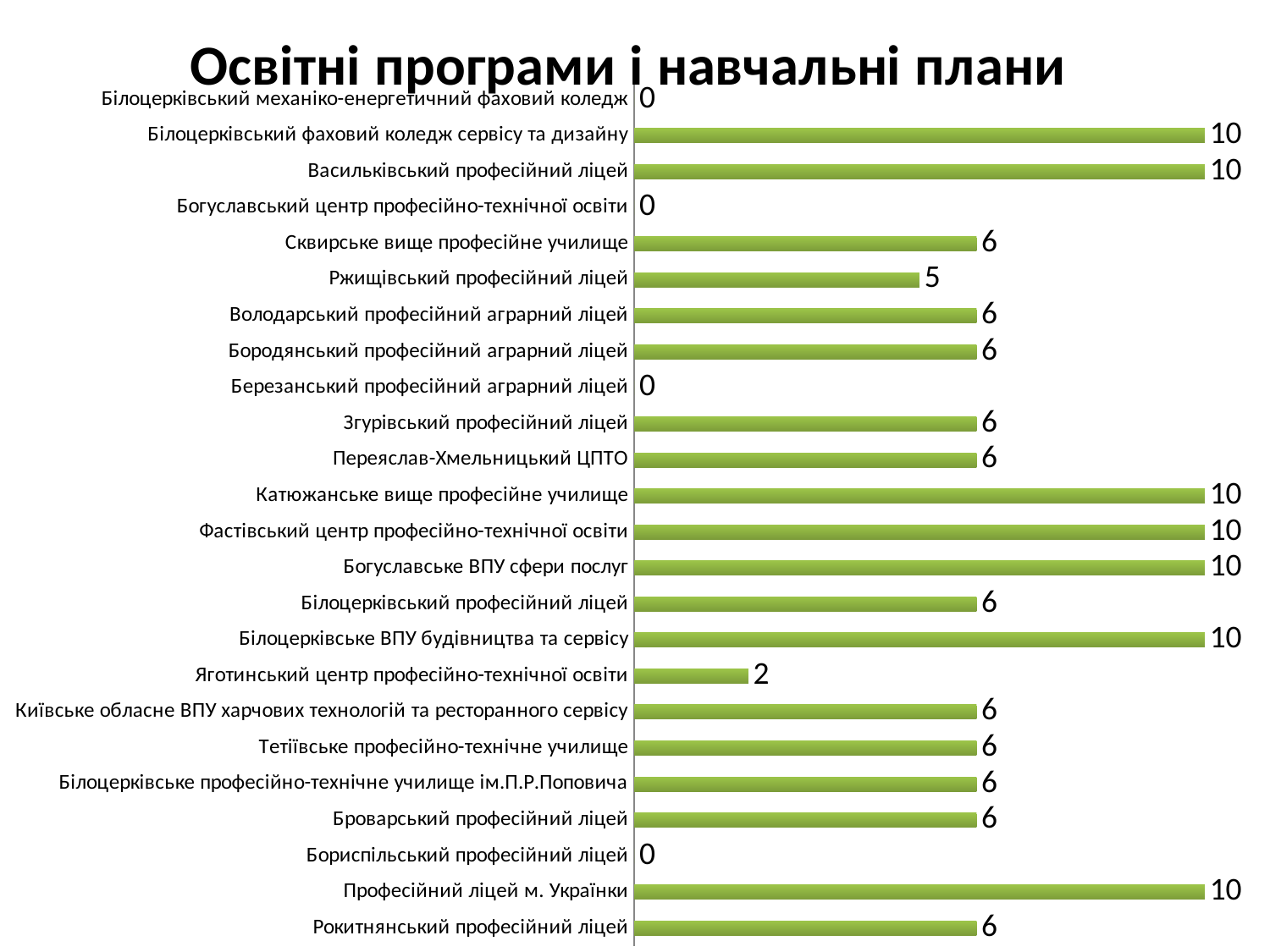
Which has a larger value, Ржищівський професійний ліцей or Броварський професійний ліцей? Броварський професійний ліцей What is the value for Катюжанське вище професійне училище? 10 How many categories are shown in the chart? 24 What is the difference between the values for Сквирське вище професійне училище and Яготинський центр професійно-технічної освіти? 4 What is the value for Яготинський центр професійно-технічної освіти? 2 What type of chart is shown on the slide? Bar chart Which has a larger value, Богуславське ВПУ сфери послуг or Білоцерківський професійний ліцей? Богуславське ВПУ сфери послуг What is the value for Рокитнянський професійний ліцей? 6 What is the value for Ржищівський професійний ліцей? 5 What is the difference between the values for Васильківський професійний ліцей and Ржищівський професійний ліцей? 5 What is the value for Бориспільський професійний ліцей? 0 How many categories have a value of 0? 4